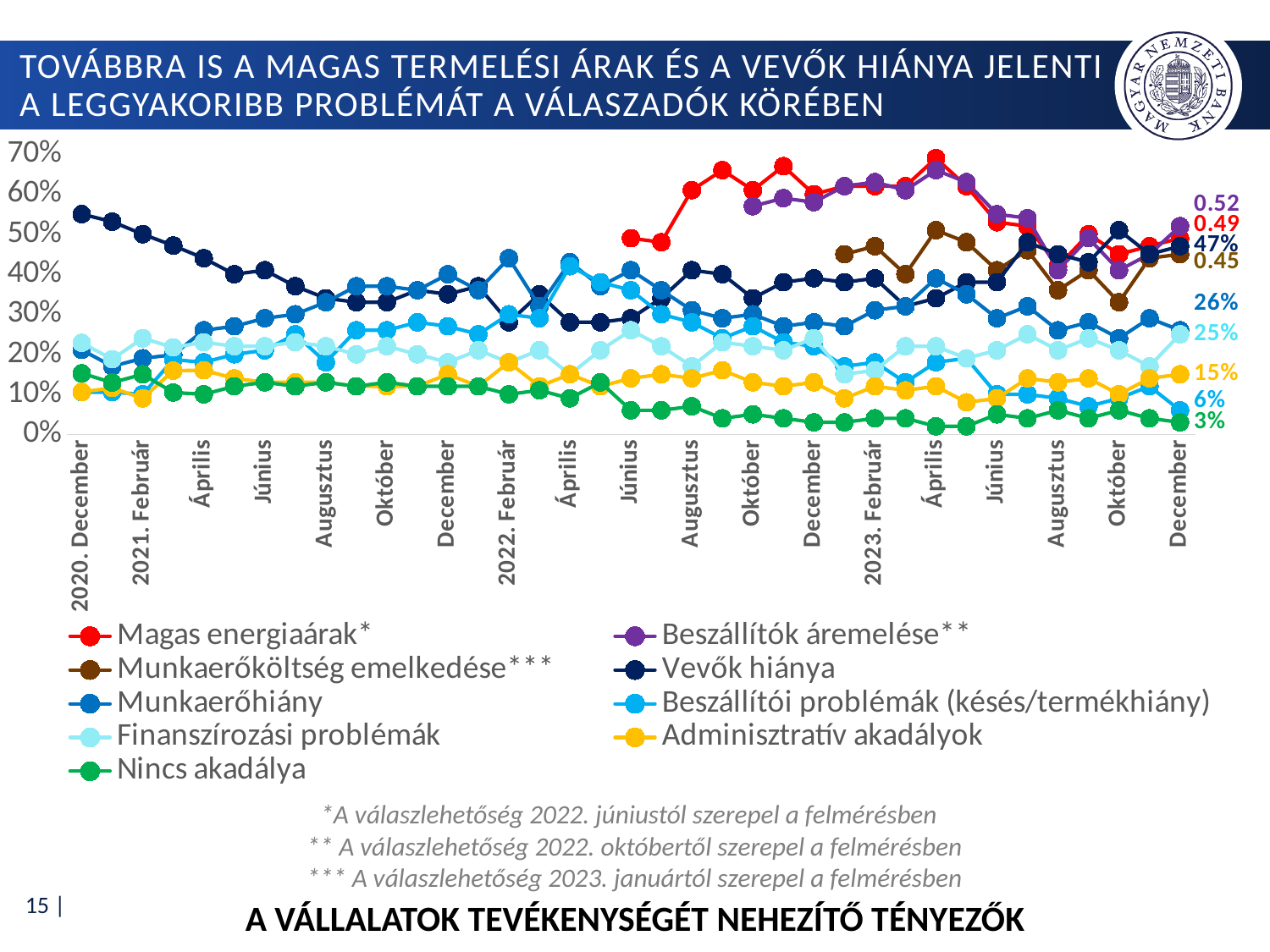
Which series has the lowest value at 2023 December? Nincs akadálya Which series has the highest value at 2023 December? Beszállítók áremelése How many series does the legend list? 9 What is the value labelled for Beszállítók áremelése at the end of the series (2023 December)? 0.52 What is the value labelled for Adminisztratív akadályok at the end of the series (2023 December)? 15% What is the value labelled for Vevők hiánya at the end of the series (2023 December)? 47% What is the difference between the 2023 December values of Vevők hiánya (47%) and Munkaerőhiány (26%)? 21 percentage points At 2023 December, which is larger: Munkaerőhiány or Beszállítói problémák (késés/termékhiány)? Munkaerőhiány Does the Vevők hiánya series rise or fall between 2020 December and 2021 December? fall What is the value labelled for Nincs akadálya at the end of the series (2023 December)? 3% Is the value for Vevők hiánya at 2020 December greater or less than 50%? greater What kind of chart is shown on the slide? line chart